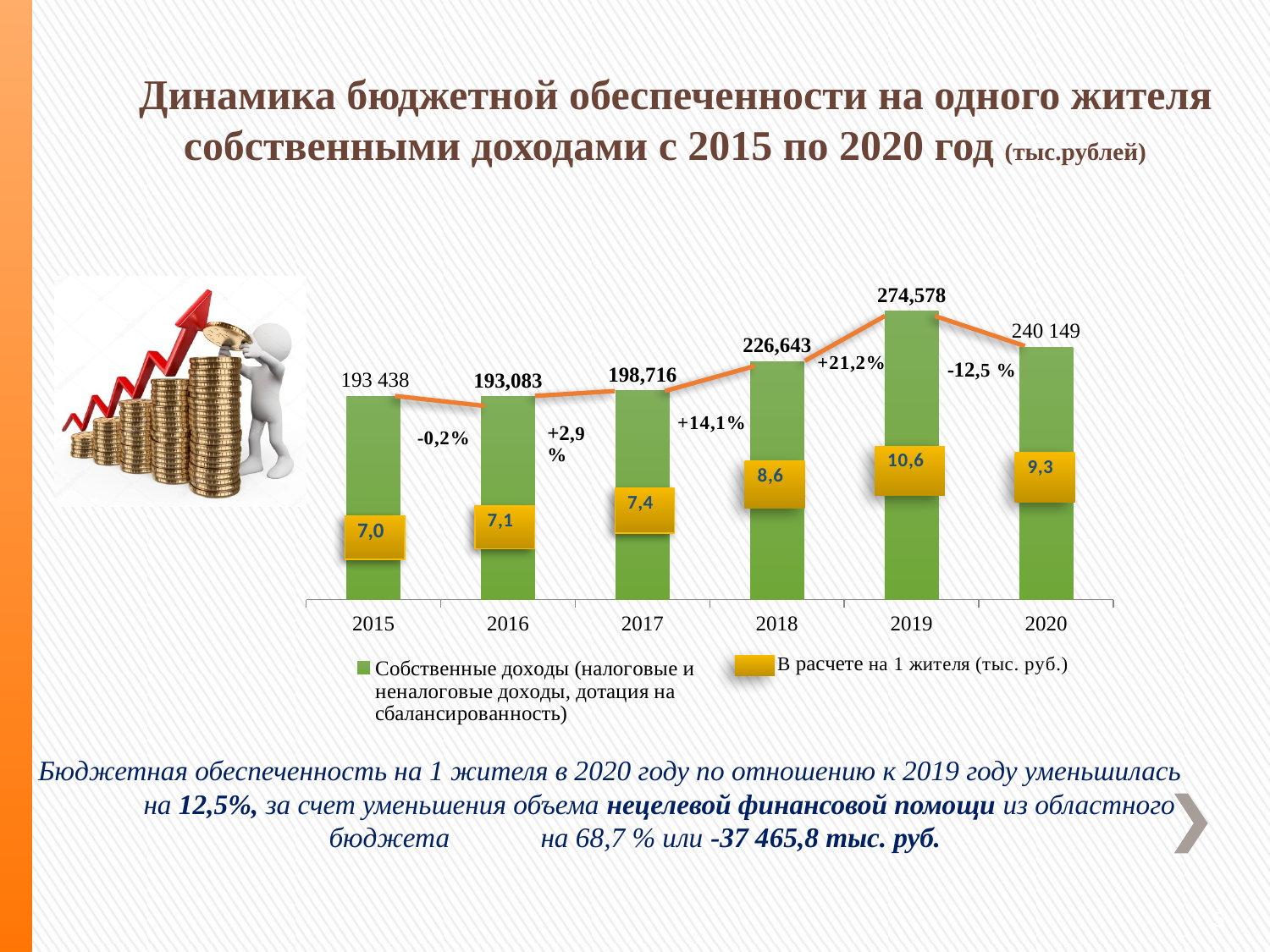
What percentage change is shown between 2018 and 2019? +21,2% How many entries does the legend list? 2 What is the difference between the per-resident values for 2019 and 2020? 1,3 Which year has the highest own revenues? 2019 Which year has the lowest per-resident value? 2015 What is the value of own revenues (Собственные доходы) for 2019? 274,578 Which is larger, the own revenues for 2017 or for 2018? 2018 Do the per-resident values rise or fall from 2015 to 2019? Rise What is the per-resident value (В расчете на 1 жителя) shown for 2018? 8,6 What is the value of own revenues for 2015? 193 438 What kind of chart is shown on the slide? Bar chart with a line How many years are shown on the x axis? 6